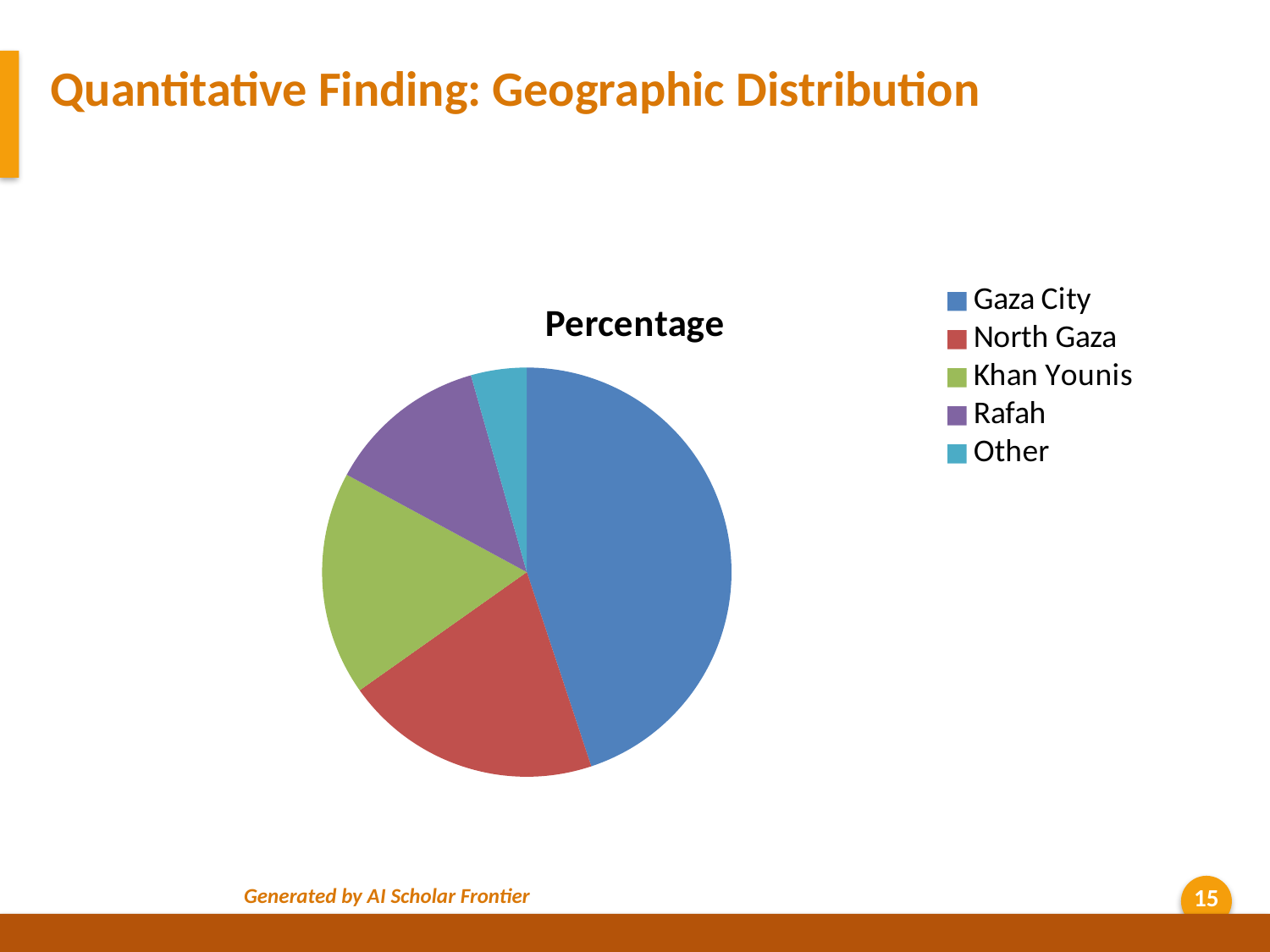
Which slice is larger, Khan Younis or Rafah? Khan Younis Which slice is larger, Gaza City or Khan Younis? Gaza City Which slice is larger, Gaza City or North Gaza? Gaza City What kind of chart is shown on the slide? pie chart What is the title of the chart? Percentage Which category has the largest slice of the pie? Gaza City Which category has the smallest slice of the pie? Other Which category is shown in blue in the legend? Gaza City How many categories does the pie chart show? 5 Which category is listed last in the legend? Other